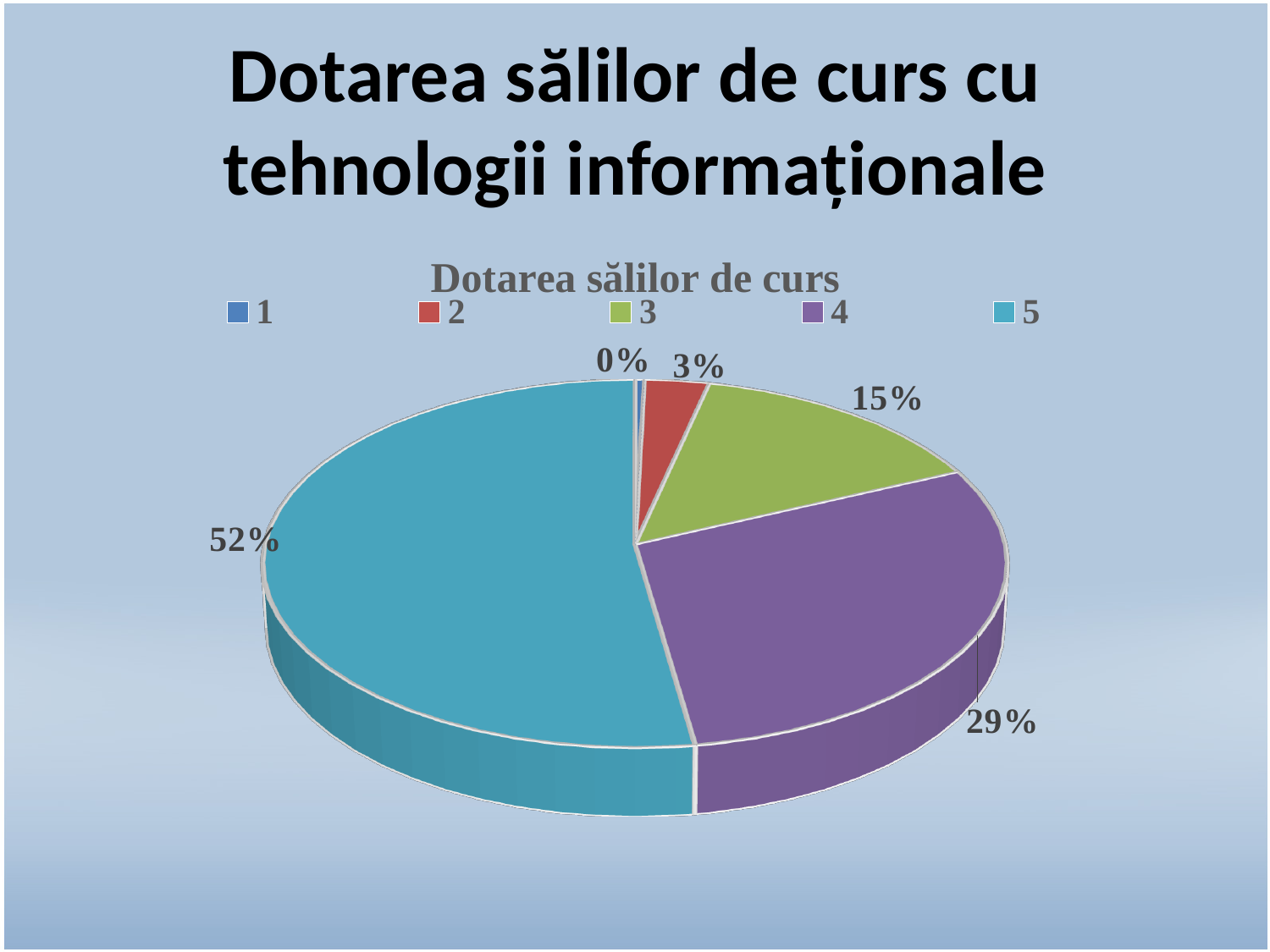
What share of the pie does category 1 have? 0% What is the difference between the shares of category 5 and category 4? 23% What kind of chart is shown on the slide? pie chart How many categories does the legend list? 5 What share of the pie does category 2 have? 3% Which is larger, the share of category 3 or category 4? 4 What share of the pie does category 5 have? 52% Which category has the smallest slice? 1 What is the title of the chart? Dotarea sălilor de curs Which category has the largest slice? 5